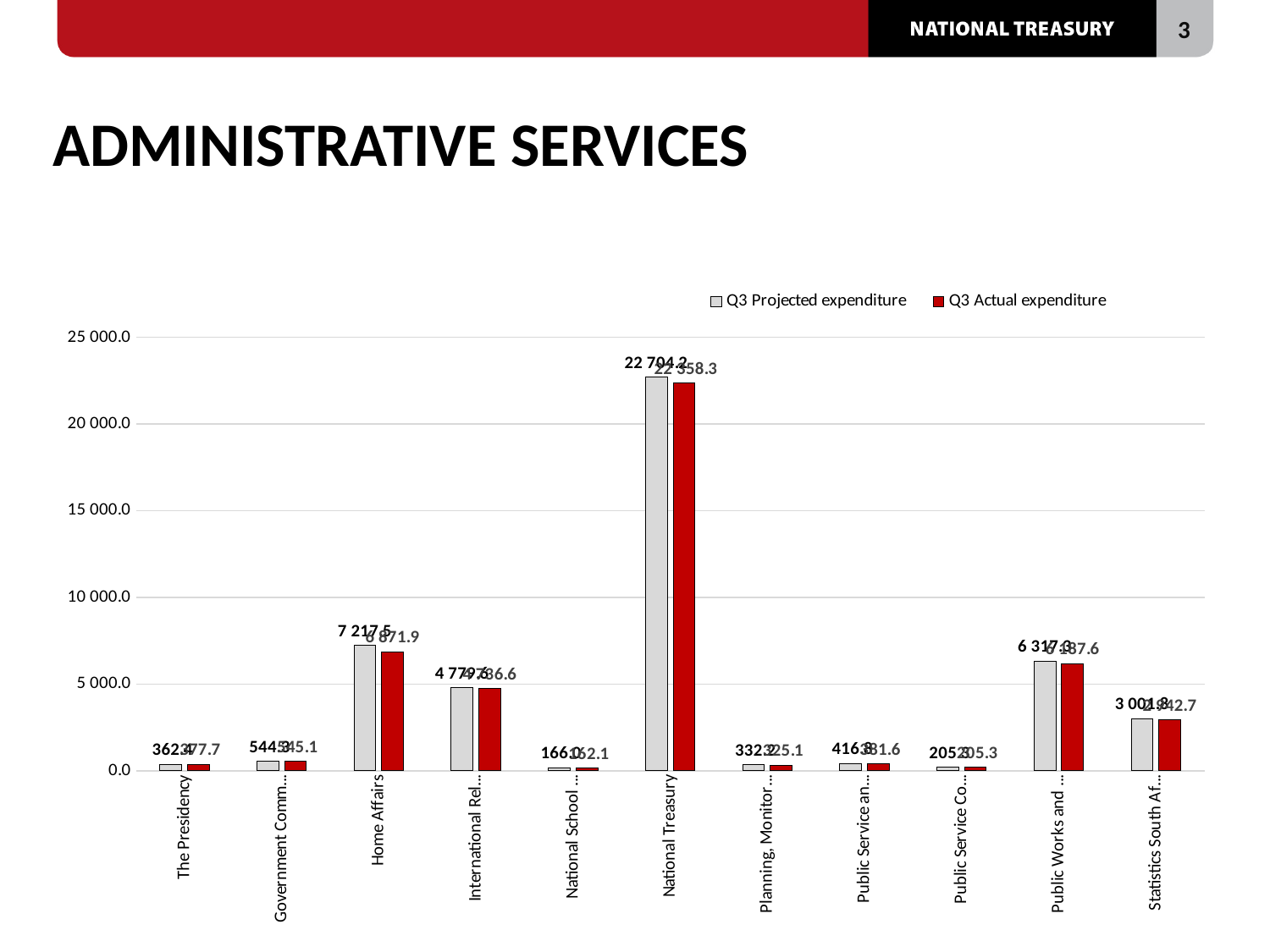
Is the Q3 Projected expenditure for Home Affairs greater or less than 5 000.0? greater For National Treasury, which is larger: Q3 Projected expenditure or Q3 Actual expenditure? Q3 Projected expenditure What are the two series named in the chart's legend? Q3 Projected expenditure and Q3 Actual expenditure What is the Q3 Actual expenditure for National Treasury? 22 358.3 Is the Q3 Projected expenditure for National Treasury greater or less than 20 000.0? greater How many categories are plotted along the x axis of the chart? 11 What is the difference between the Q3 Projected expenditure and the Q3 Actual expenditure for National Treasury? 345.9 What is the Q3 Projected expenditure for National Treasury? 22 704.2 What kind of chart is shown on the slide? bar chart Which category has the highest Q3 Projected expenditure? National Treasury How many series does the chart's legend list? 2 Which has the larger Q3 Projected expenditure: Home Affairs or Public Works and ...? Home Affairs